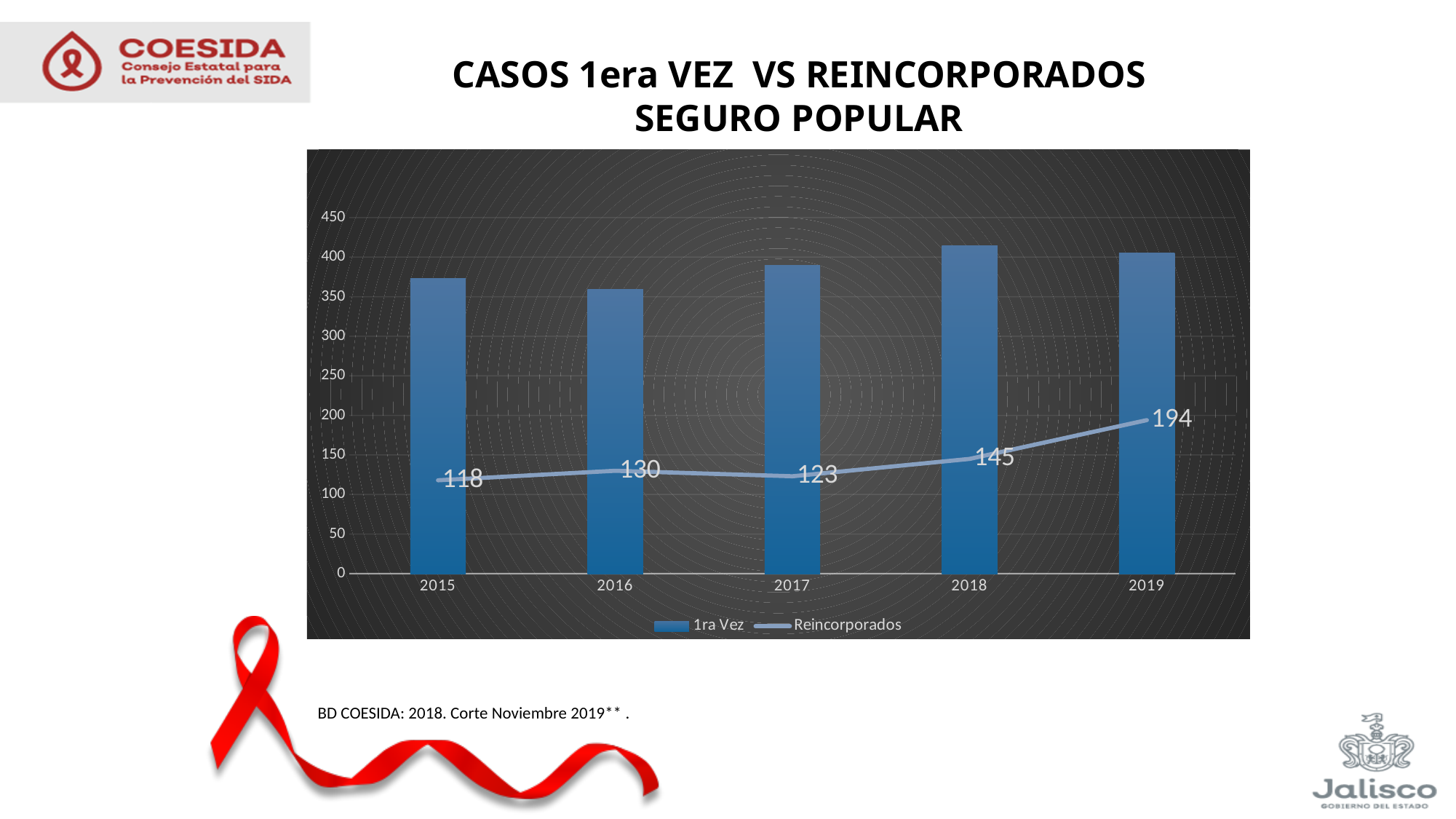
What is the Reincorporados value for 2017? 123 Which series is drawn as a line rather than bars? Reincorporados What is the Reincorporados value for 2019? 194 How many years are shown on the x axis? 5 Which year has the lowest Reincorporados value? 2015 Which year has the highest Reincorporados value? 2019 Which is larger, the Reincorporados value for 2016 or for 2017? 2016 How many series does the legend list? 2 Is the 1ra Vez value for 2016 greater or less than 400? less What is the difference between the Reincorporados values for 2019 and 2018? 49 Is the 1ra Vez value for 2018 greater or less than 400? greater What is the Reincorporados value for 2015? 118